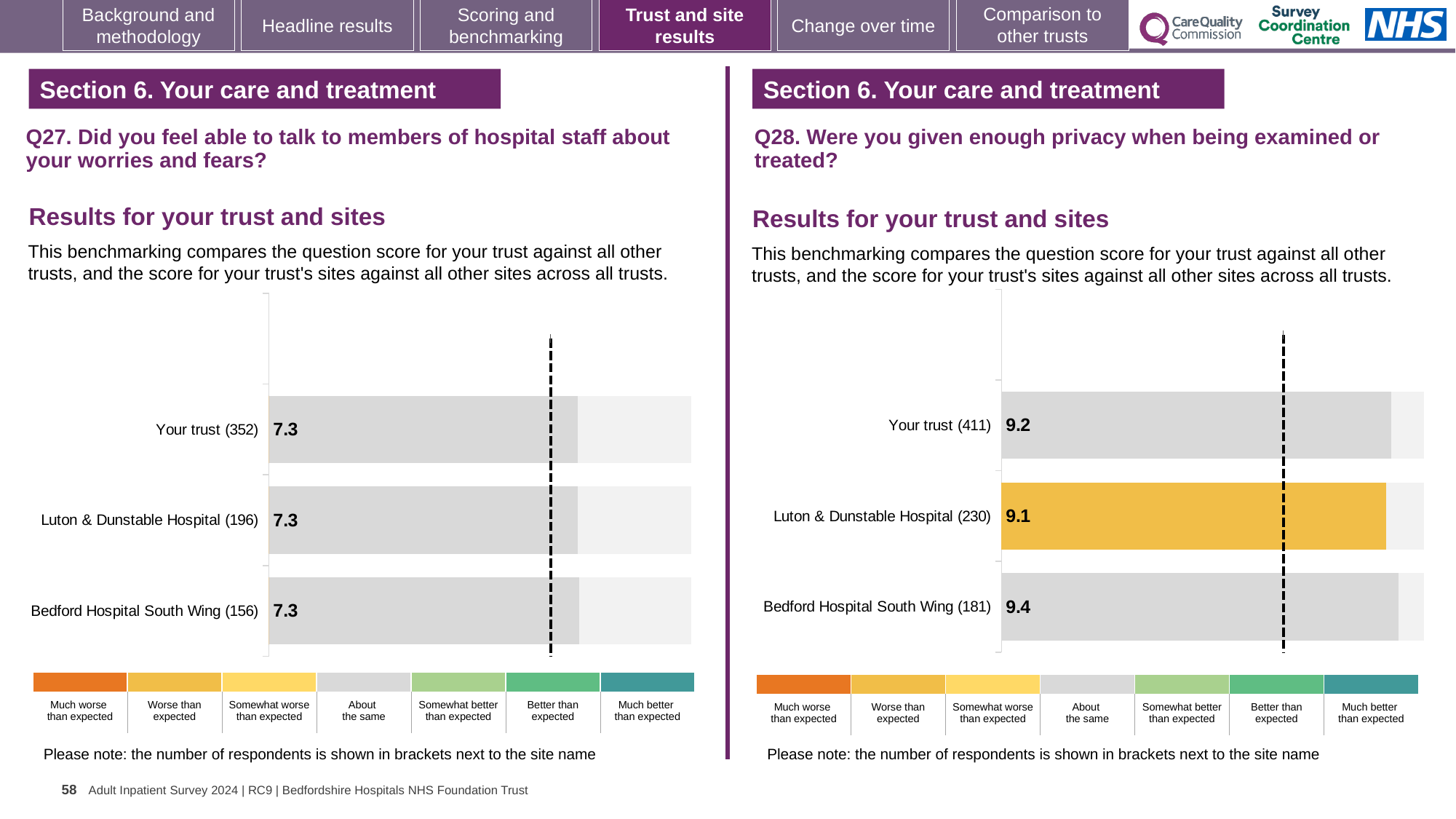
On the Q28 chart (right), how many respondents are shown in brackets for Your trust? 411 On the Q28 chart (right), which bar is coloured yellow/orange rather than grey? Luton & Dunstable Hospital On the Q27 chart (left), what is the score for Your trust? 7.3 How many bars are plotted on the Q27 chart (left)? 3 On the Q28 chart (right), what is the score for Luton & Dunstable Hospital? 9.1 On the Q28 chart (right), what is the score for Your trust? 9.2 On the Q28 chart (right), which site or trust has the highest score? Bedford Hospital South Wing On the Q28 chart (right), which site or trust has the lowest score? Luton & Dunstable Hospital On the Q28 chart (right), which has the larger score, Your trust or Bedford Hospital South Wing? Bedford Hospital South Wing On the Q27 chart (left), what is the score for Bedford Hospital South Wing? 7.3 What type of chart is used on the Q28 chart (right)? Bar chart On the Q28 chart (right), what is the difference between the scores for Bedford Hospital South Wing and Luton & Dunstable Hospital? 0.3